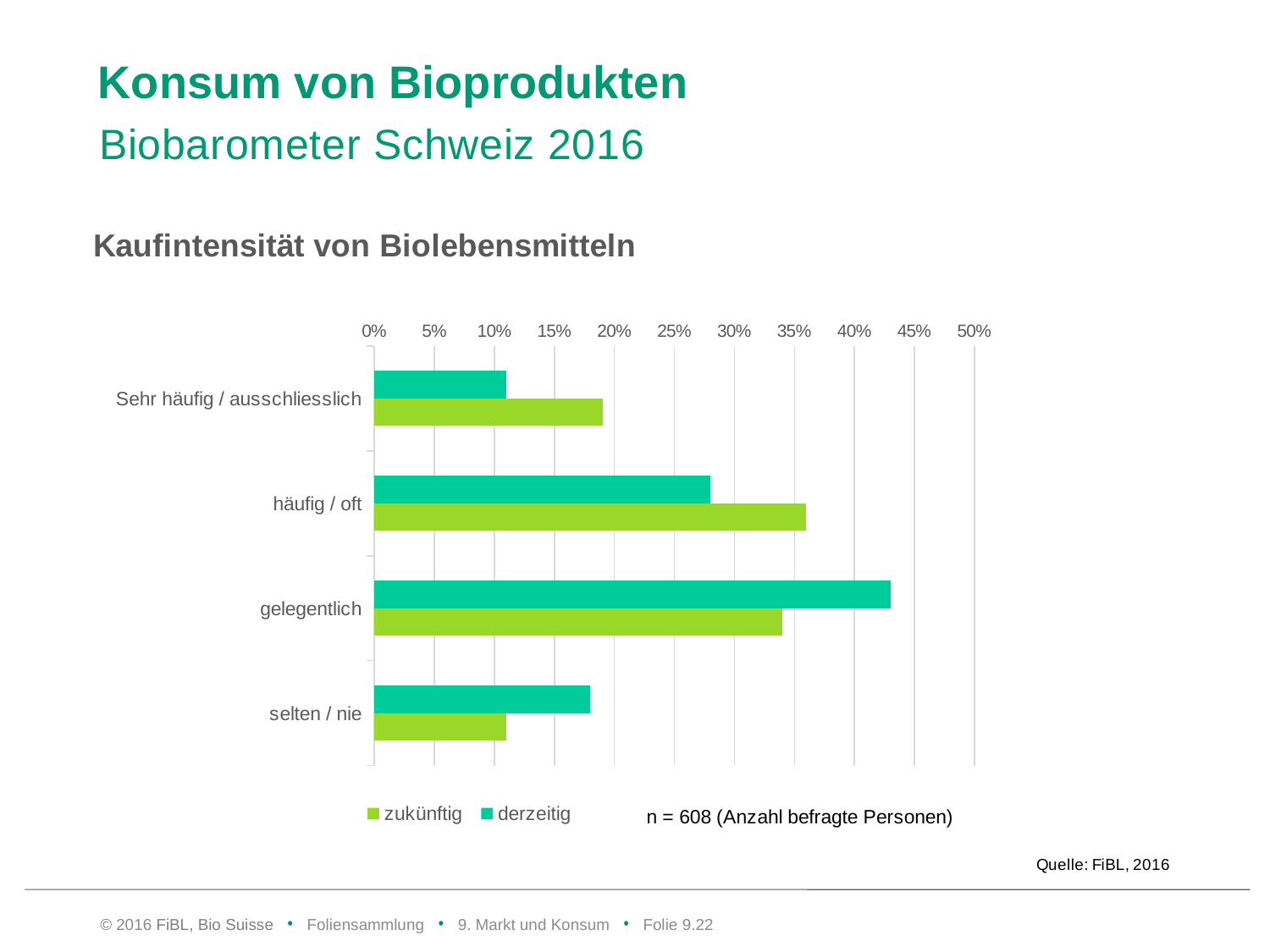
Is the 'derzeitig' value for 'gelegentlich' greater or less than 40%? greater How many series does the legend list? 2 How many categories are shown on the chart? 4 Which category has the highest value for the 'derzeitig' series? gelegentlich Which category has the lowest value for the 'derzeitig' series? Sehr häufig / ausschliesslich Is the 'derzeitig' value for 'häufig / oft' greater or less than 25%? greater Which category has the highest value for the 'zukünftig' series? häufig / oft For 'häufig / oft', which series has the larger value, 'zukünftig' or 'derzeitig'? zukünftig What kind of chart is shown on the slide? bar chart For 'gelegentlich', which series has the larger value, 'zukünftig' or 'derzeitig'? derzeitig Is the 'zukünftig' value for 'selten / nie' greater or less than 15%? less What is the number of surveyed persons (n) stated below the chart? 608